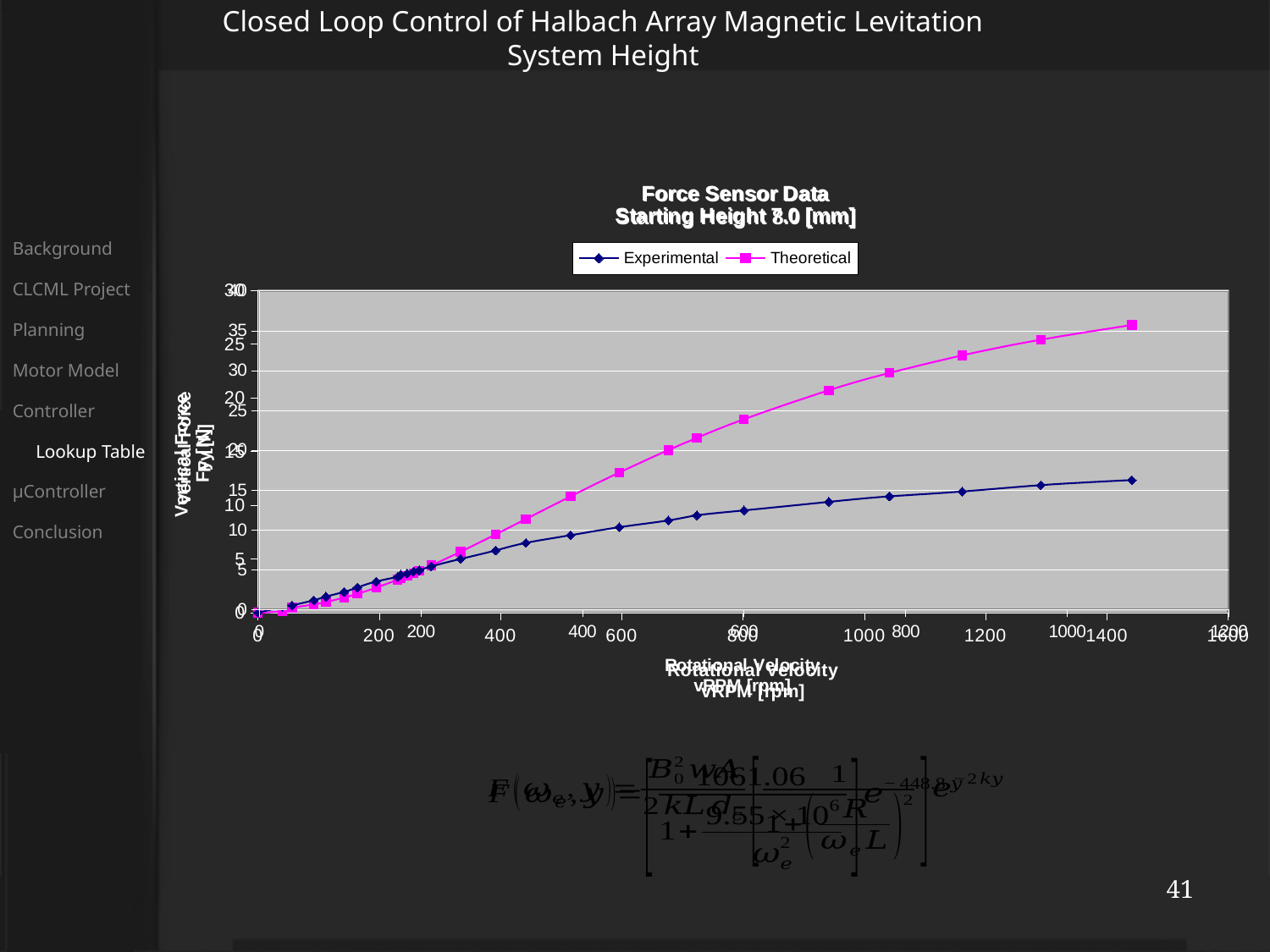
Does the Experimental vertical force rise or fall as rotational velocity increases? rise Does the Theoretical vertical force rise or fall as rotational velocity increases? rise Which series is drawn in magenta with square markers? Theoretical Which series reaches the highest vertical force on the chart? Theoretical What are the two series named in the chart legend? Experimental and Theoretical How many series does the chart legend list? 2 Which series stays lower across the upper range of rotational velocity? Experimental At the highest rotational velocity plotted, which series has the larger vertical force, Experimental or Theoretical? Theoretical What kind of chart is shown on the slide? line chart